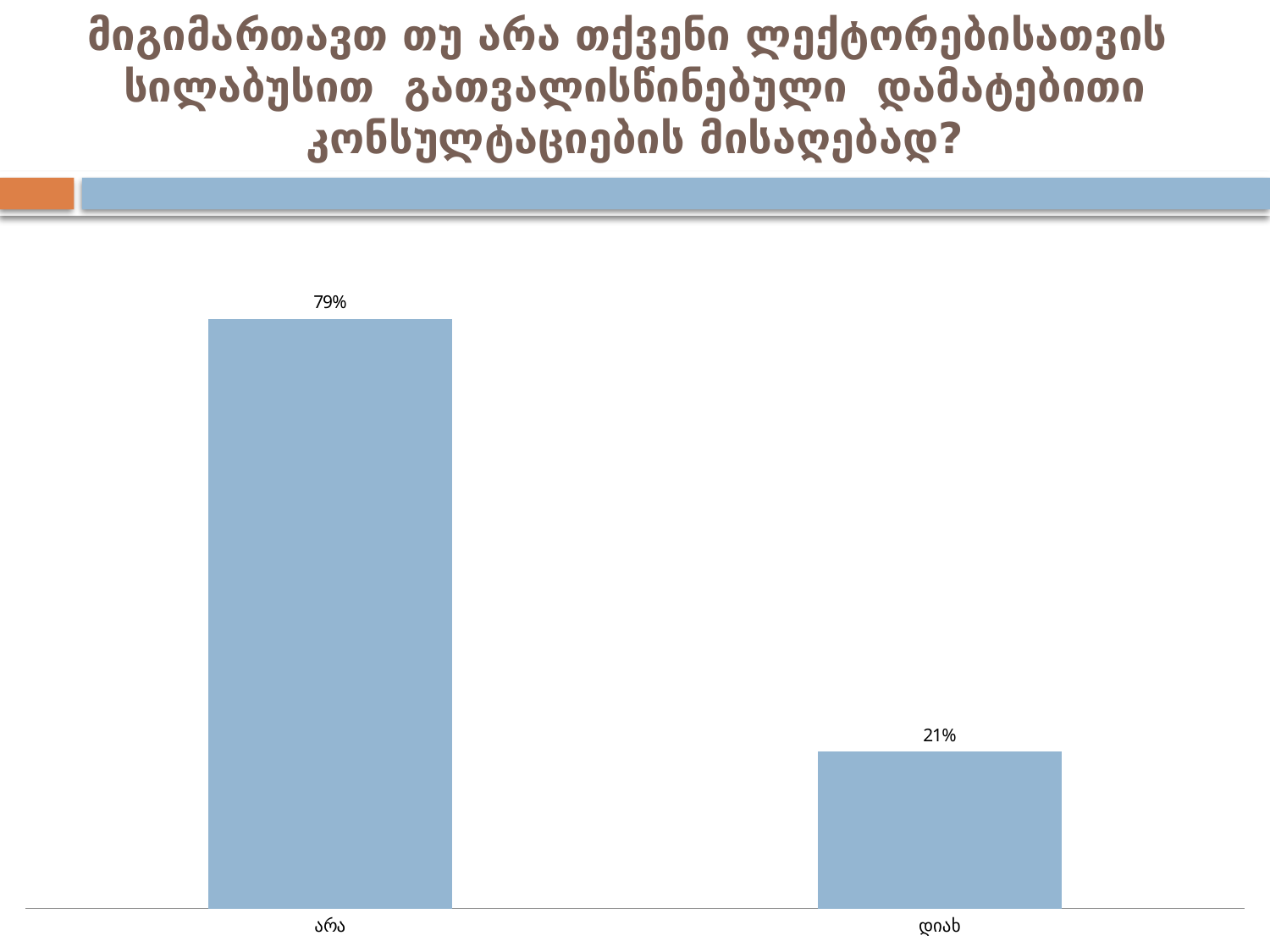
What is the value for the category "დიახ"? 21% Which category has the highest value? არა How many categories are shown in the chart? 2 What are the category labels on the x axis, from left to right? არა, დიახ What is the total of the two values shown in the chart? 100% What is the value for the category "არა"? 79% What is the difference between the values for "არა" and "დიახ"? 58% What colour are the bars in the chart? Light blue What kind of chart is shown on the slide? Bar chart Which category has the lowest value? დიახ Which is larger, the value for "არა" or the value for "დიახ"? არა